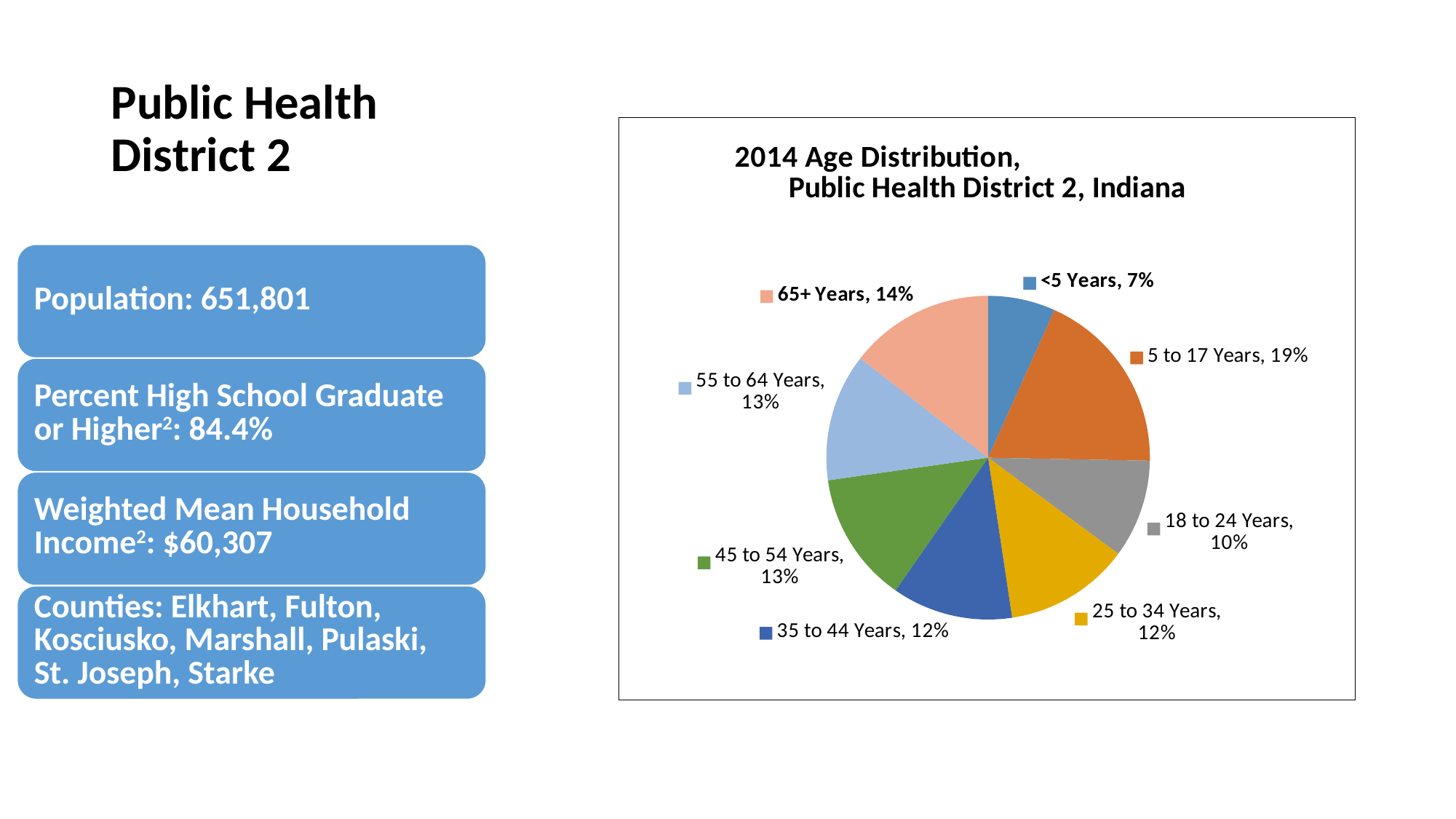
What is the title of the chart? 2014 Age Distribution, Public Health District 2, Indiana How many age groups are shown in the pie chart? 8 Which age group has the largest share of the pie? 5 to 17 Years What is the difference in percentage points between the 5 to 17 Years group and the 65+ Years group? 5 What percentage of the population is <5 Years? 7% What colour is the slice for 45 to 54 Years? green What type of chart is shown on the slide? pie chart What percentage of the population is 18 to 24 Years? 10% What percentage of the population is 65+ Years? 14% Which is larger, the share for 55 to 64 Years or the share for 18 to 24 Years? 55 to 64 Years Which age group has the smallest share of the pie? <5 Years What percentage of the population is 5 to 17 Years? 19%